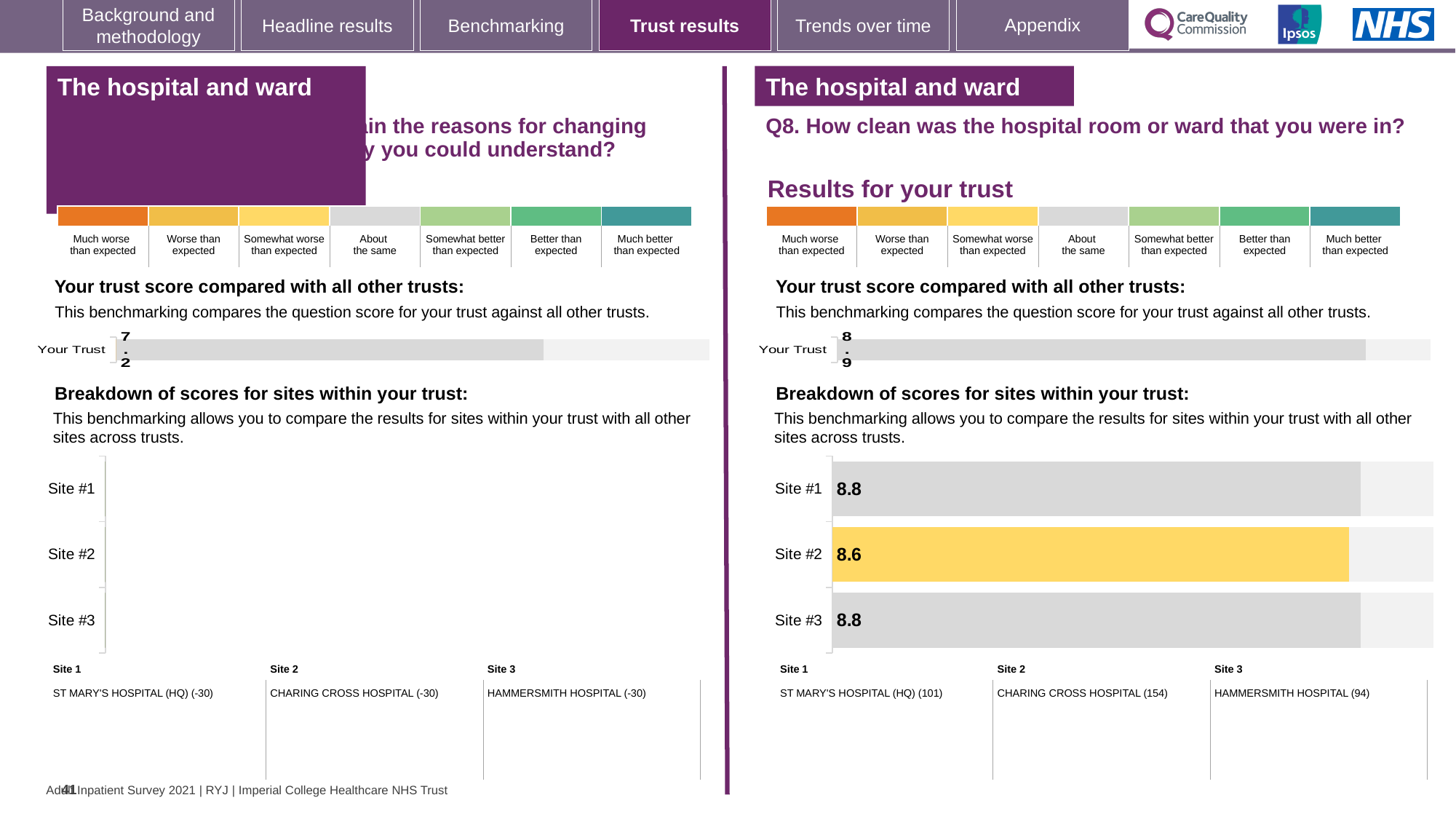
On the right-hand chart for Q8 'How clean was the hospital room or ward that you were in?', what is the trust score shown for 'Your Trust'? 8.9 How many sites are listed on the right-hand site breakdown chart for Q8? 3 On the right-hand site breakdown chart for Q8, what colour is the bar for Site #2? Yellow On the left-hand 'Your trust score compared with all other trusts' chart, what is the score shown for 'Your Trust'? 7.2 What kind of chart is the right-hand site breakdown chart for Q8? Bar chart On the right-hand site breakdown chart for Q8, what is the score for Site #3? 8.8 On the right-hand site breakdown chart for Q8, which site has the lowest score? Site #2 On the right-hand site breakdown chart for Q8, what is the difference between the scores for Site #1 and Site #2? 0.2 On the right-hand site breakdown chart for Q8, what is the score for Site #1? 8.8 On the right-hand site breakdown chart for Q8, which has the higher score, Site #2 or Site #3? Site #3 On the right-hand 'Breakdown of scores for sites within your trust' chart for Q8, what is the score for Site #2? 8.6 Which trust score is higher: the one on the left-hand chart or the one on the right-hand Q8 chart? The right-hand Q8 chart (8.9)